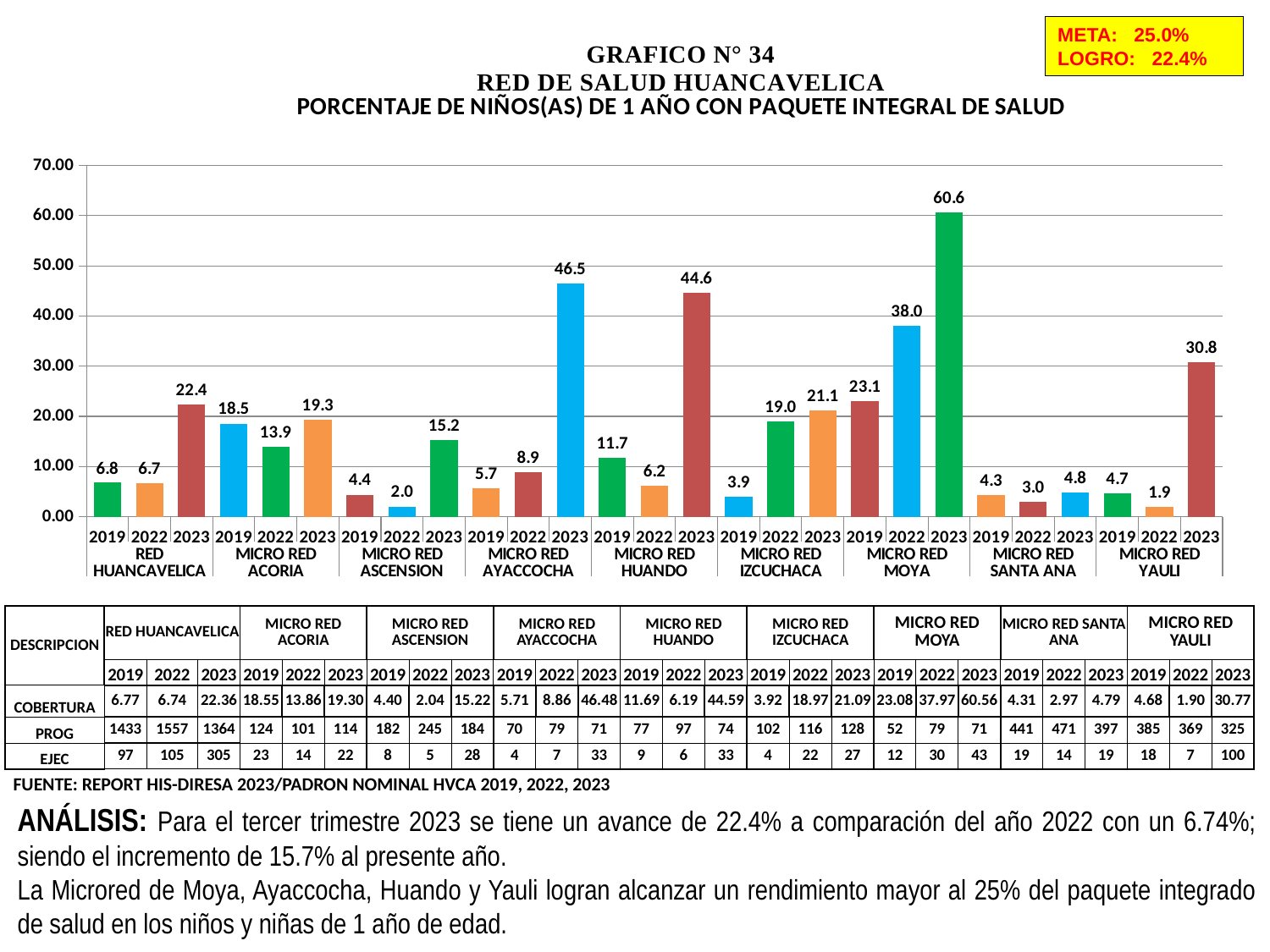
Which is larger: the 2023 value for MICRO RED AYACCOCHA or the 2023 value for MICRO RED HUANDO? MICRO RED AYACCOCHA What is the value for 2019 in the MICRO RED HUANDO group? 11.7 How many groups (redes/micro redes) are shown on the x axis? 9 Which bar has the highest value on the chart? MICRO RED MOYA 2023 (60.6) Which bar has the lowest value on the chart? MICRO RED YAULI 2022 (1.9) Do the values for MICRO RED MOYA rise or fall from 2019 to 2023? rise What is the difference between the 2023 and 2022 values for RED HUANCAVELICA? 15.7 What is the difference between the 2023 and 2022 values for MICRO RED MOYA? 22.6 What kind of chart is shown on the slide? bar chart What is the value for 2023 in the MICRO RED MOYA group? 60.6 Is the value for 2022 in the MICRO RED IZCUCHACA group greater or less than 20? less What is the value for 2022 in the RED HUANCAVELICA group? 6.7